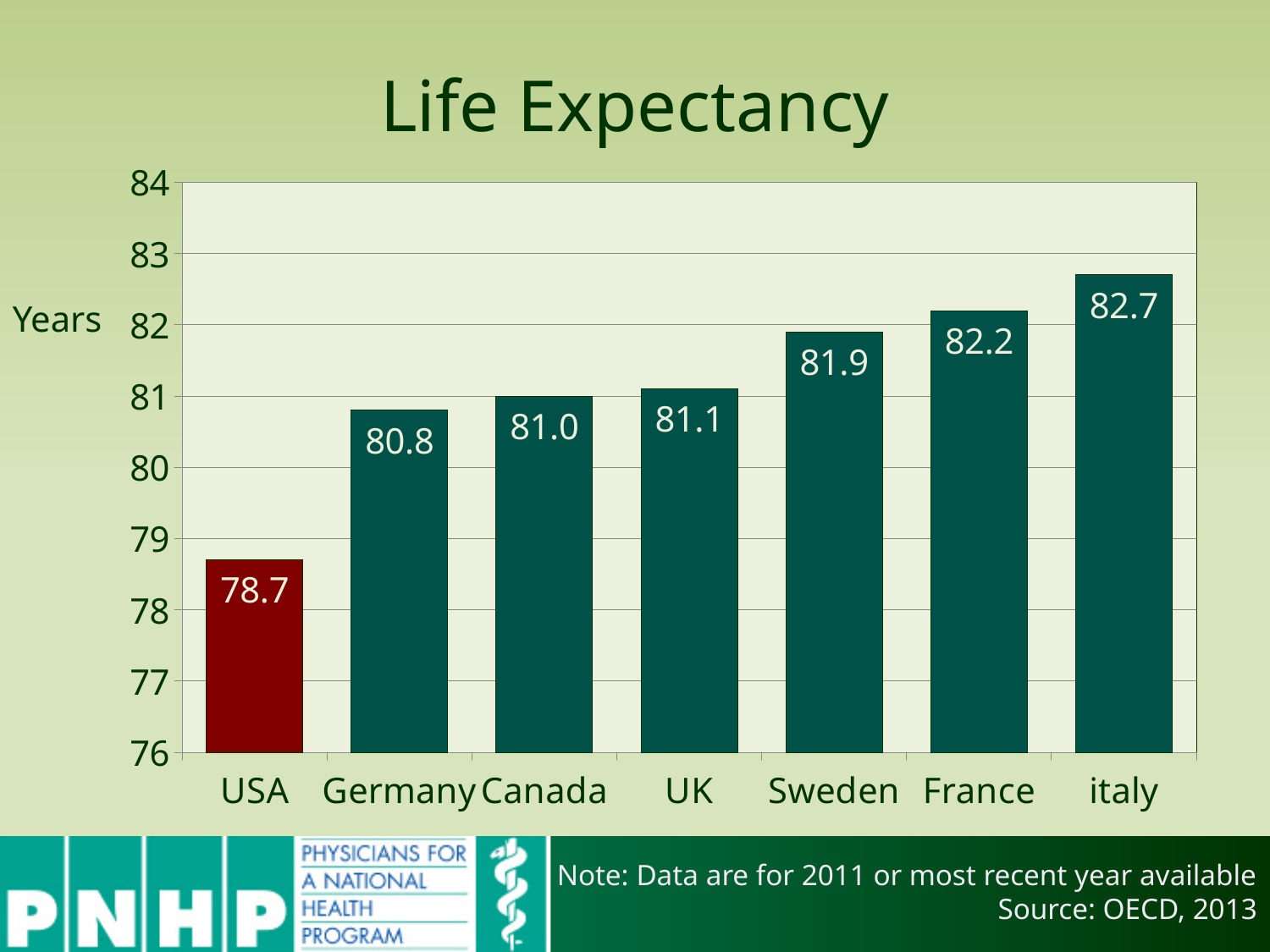
What is the difference between the life expectancy of Italy and the USA? 4.0 Is the value for the USA greater or less than 79? less What is the difference between the life expectancy of France and the UK? 1.1 Which has a higher life expectancy, Canada or Sweden? Sweden Which bar is coloured differently (red) from the others? USA Which country has the lowest life expectancy on the chart? USA What is the life expectancy value shown for the USA? 78.7 Which country has the highest life expectancy on the chart? italy What kind of chart is shown on the slide? bar chart What is the life expectancy value shown for Sweden? 81.9 What is the life expectancy value shown for Germany? 80.8 How many countries are shown on the chart? 7